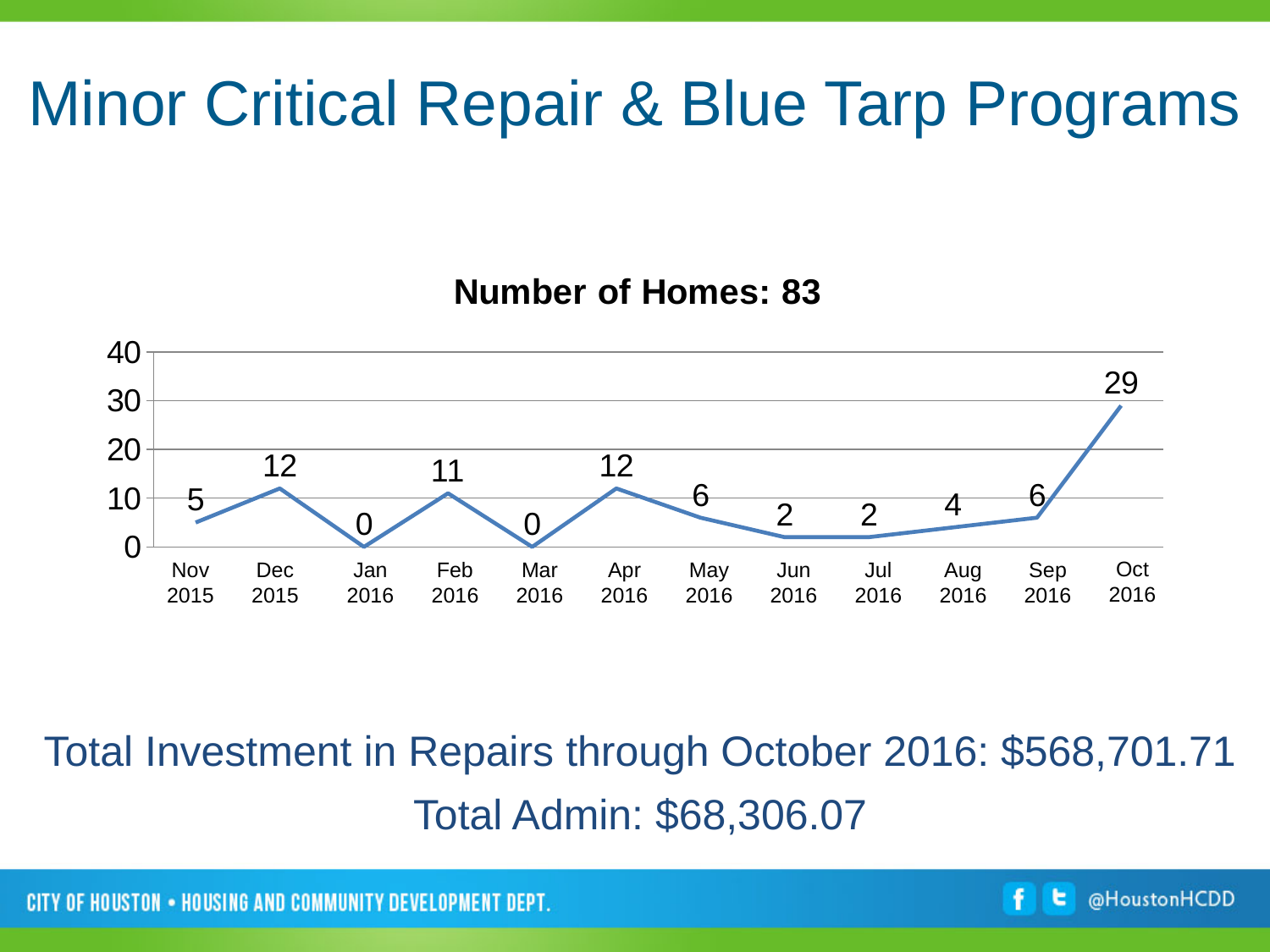
Is the value for Oct 2016 greater or less than 20? greater What is the number of homes for Feb 2016? 11 What is the difference between the values for Oct 2016 and Sep 2016? 23 What kind of chart is shown on the slide? line chart Which months have a value of 0? Jan 2016 and Mar 2016 What is the number of homes for Oct 2016? 29 Which month has the highest number of homes? Oct 2016 What is the title of the chart? Number of Homes: 83 Which is larger, the value for Apr 2016 or the value for May 2016? Apr 2016 What is the number of homes for Nov 2015? 5 How many months are plotted on the chart? 12 What is the difference between the values for Dec 2015 and Nov 2015? 7